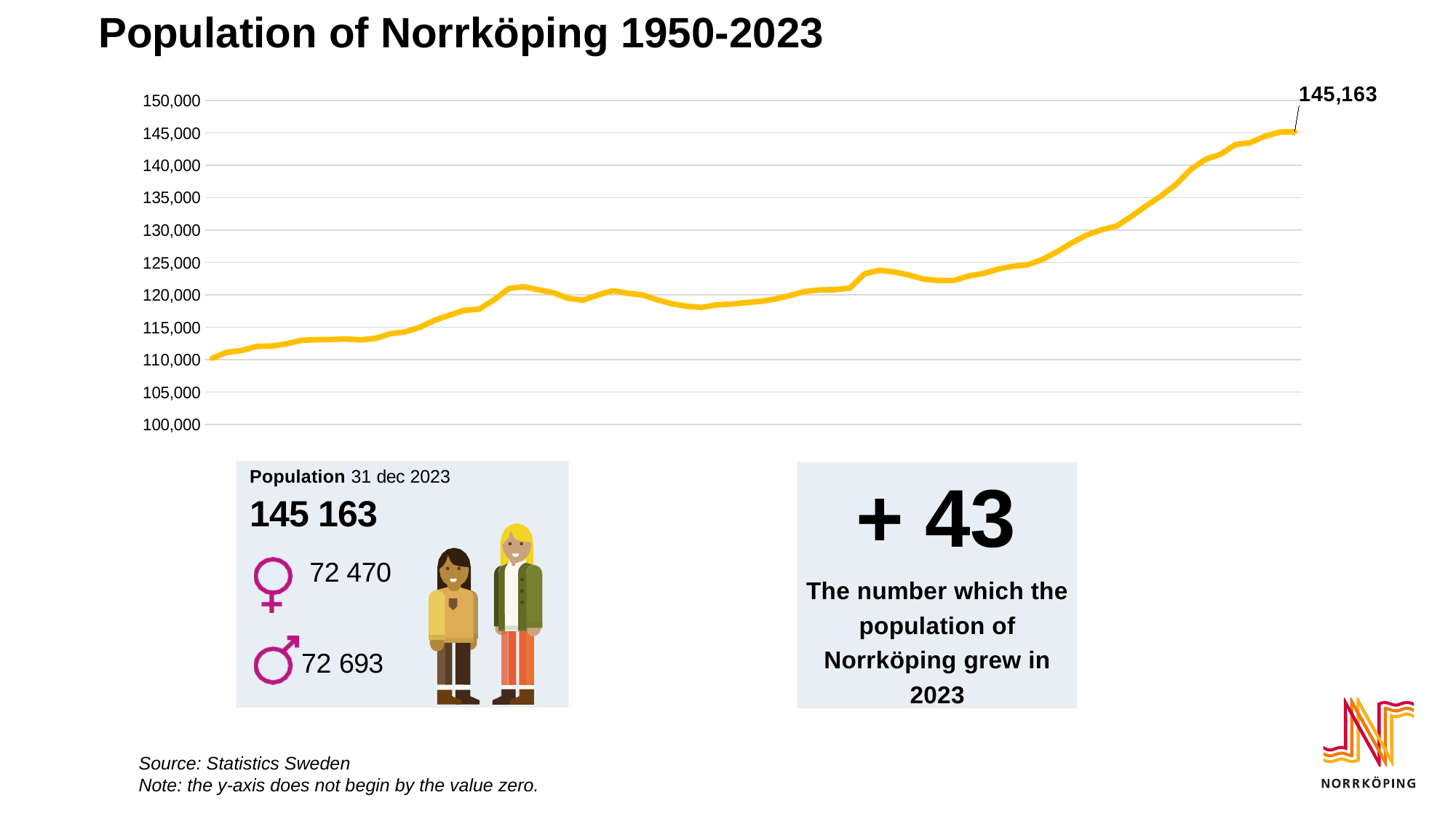
Is the value at the last point of the line (2023) greater or less than 140,000? greater What is the highest value shown on the y-axis of the chart? 150,000 What kind of chart is shown on the slide? line chart What is the title of the chart? Population of Norrköping 1950-2023 Is the value at the first point of the line (1950) greater or less than 115,000? less What is the lowest value shown on the y-axis of the chart? 100,000 Is the lowest value on the line greater or less than 120,000? less Which end of the line, the first point (1950) or the last point (2023), has the higher value? the last point (2023) What value is printed as the data label at the end of the line (2023)? 145,163 Does the population line generally rise or fall from left to right across the chart? rise